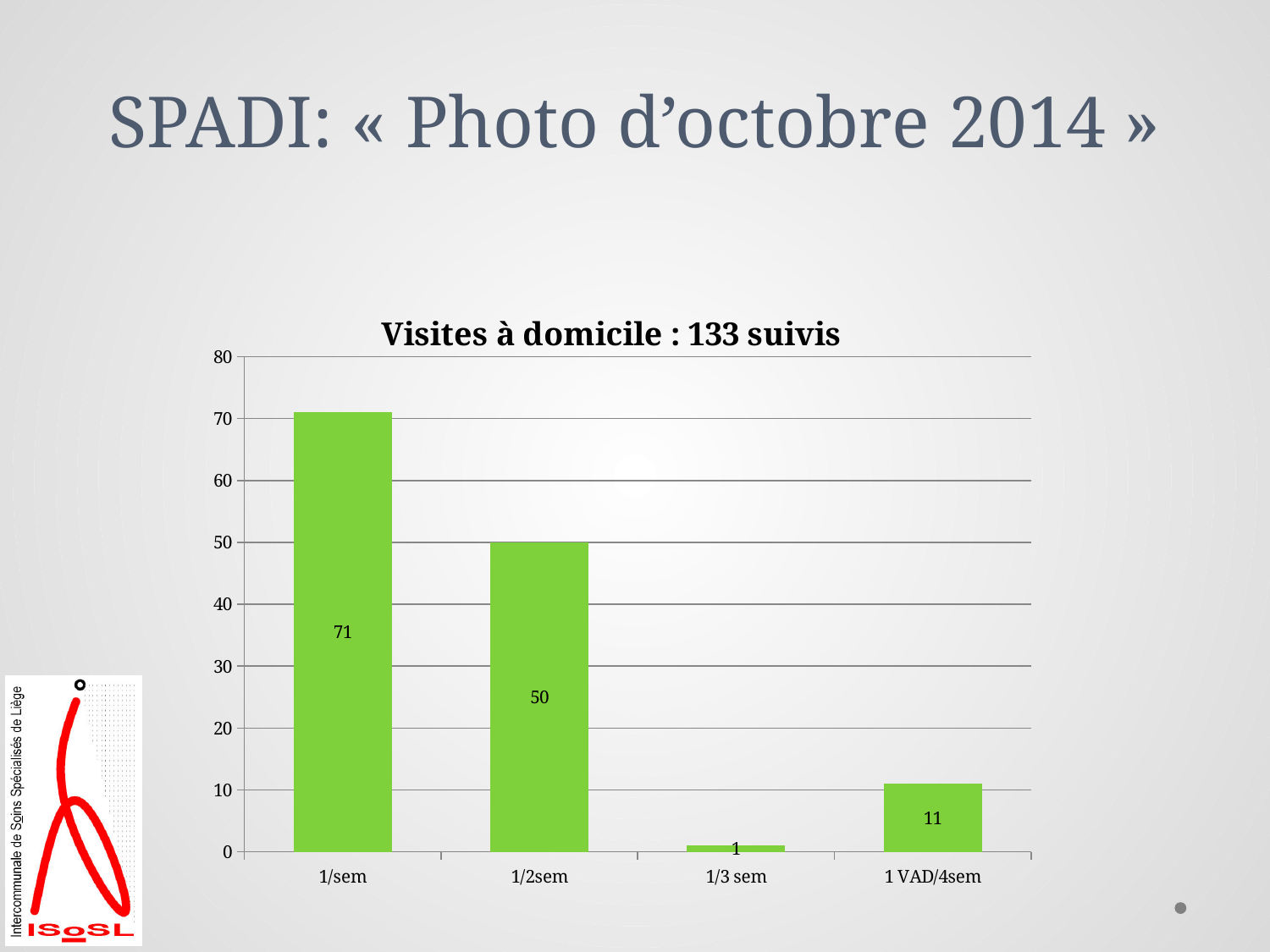
What is the title of the chart? Visites à domicile : 133 suivis Is the value for 1/sem greater or less than 60? greater How many categories are shown on the x axis? 4 What is the value for 1/sem? 71 Which is larger, the value for 1/2sem or the value for 1 VAD/4sem? 1/2sem Which category has the highest value? 1/sem Which category has the lowest value? 1/3 sem What kind of chart is shown on the slide? bar chart What colour are the bars in the chart? green What is the difference between the values for 1/sem and 1/2sem? 21 What is the value for 1 VAD/4sem? 11 What is the value for 1/2sem? 50